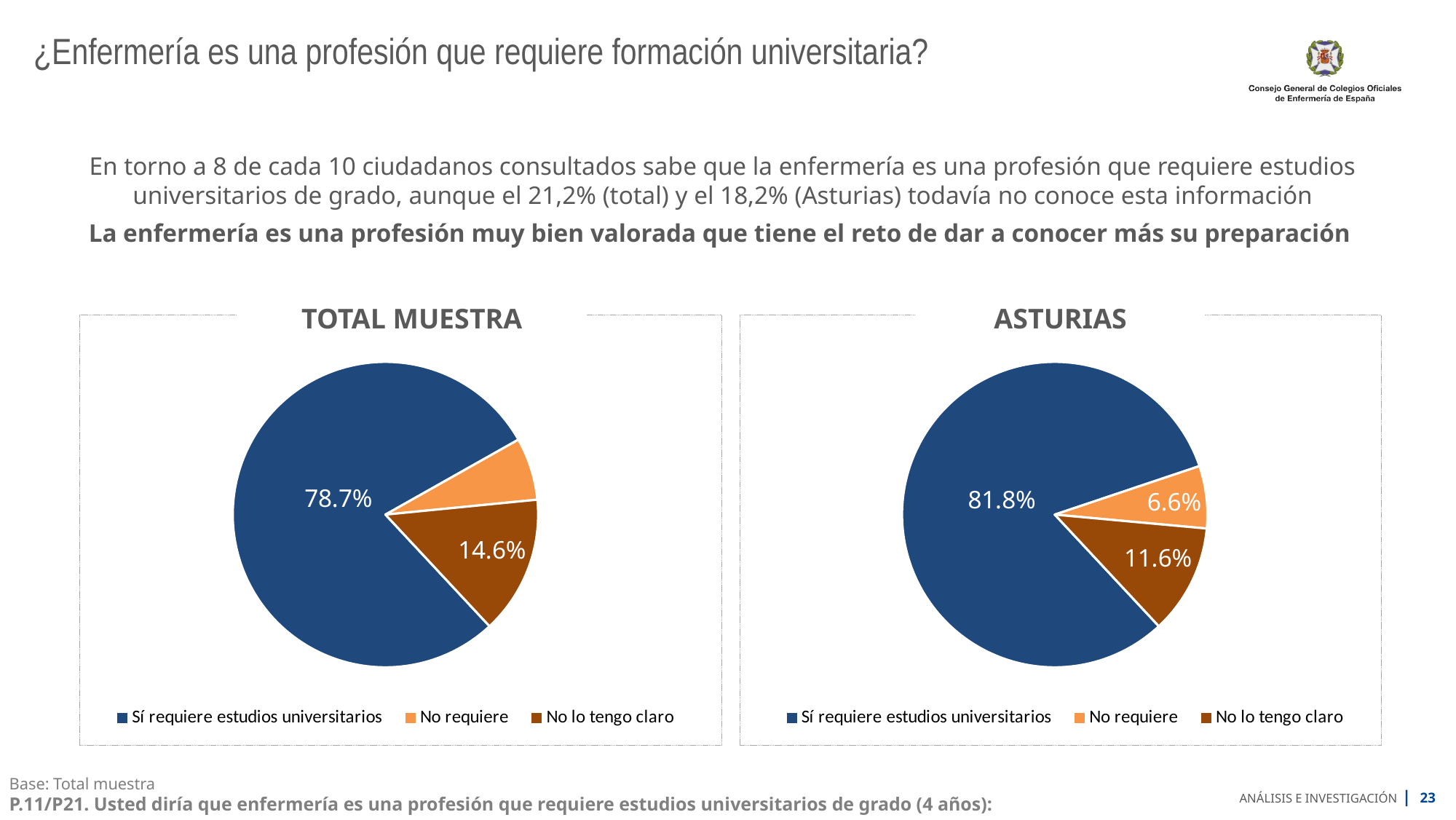
In the ASTURIAS chart, what percentage answered "No lo tengo claro"? 11.6% Which chart shows a larger share for "Sí requiere estudios universitarios", TOTAL MUESTRA or ASTURIAS? ASTURIAS In the ASTURIAS chart, what is the difference between "No lo tengo claro" and "No requiere"? 5.0% In the TOTAL MUESTRA chart, which category has the largest slice? Sí requiere estudios universitarios In the ASTURIAS chart, what percentage answered "Sí requiere estudios universitarios"? 81.8% What kind of chart is the ASTURIAS chart? Pie chart In the ASTURIAS chart, what percentage answered "No requiere"? 6.6% In the ASTURIAS chart, which category has the smallest slice? No requiere In the TOTAL MUESTRA chart, what percentage answered "Sí requiere estudios universitarios"? 78.7% How many categories does the legend of the TOTAL MUESTRA chart list? 3 In the ASTURIAS chart, what is the difference between "Sí requiere estudios universitarios" and "No lo tengo claro"? 70.2% In the TOTAL MUESTRA chart, what percentage answered "No lo tengo claro"? 14.6%